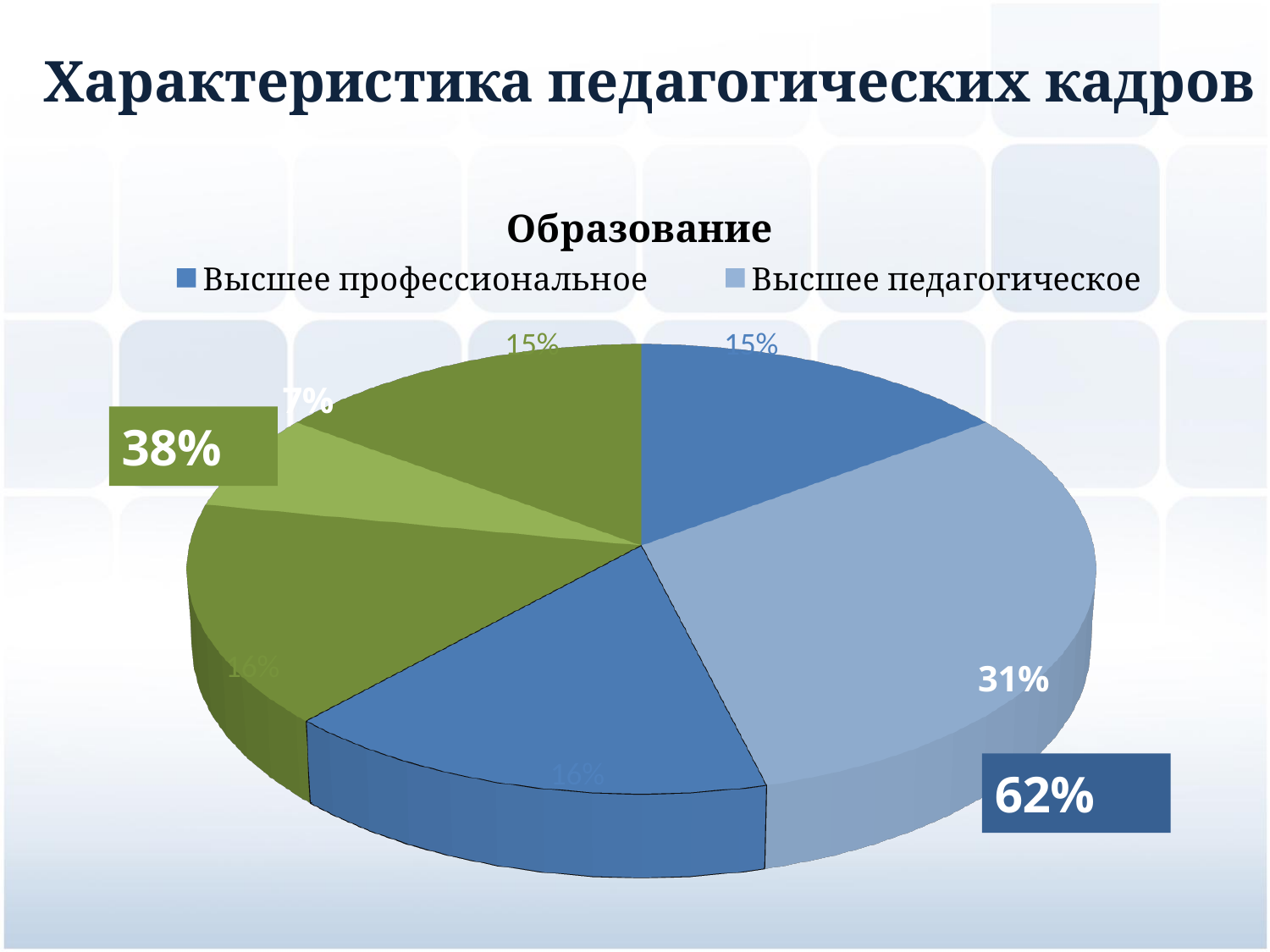
How many slices does the pie chart have? 6 Which is larger: the slice labelled 31% or the slice labelled 16%? 31% What share of the pie is labelled for Высшее педагогическое (the light blue slice)? 31% What is the smallest slice value shown on the pie chart? 7% What is the difference between the largest slice (31%) and the smallest slice (7%)? 24 percentage points How many entries does the chart legend list? 2 What is the largest slice value shown on the pie chart? 31% What share of the pie is labelled for Высшее профессиональное (the dark blue slice)? 15% What are the two legend entries of the chart? Высшее профессиональное and Высшее педагогическое What kind of chart is shown on the slide? pie chart What is the title of the chart? Образование